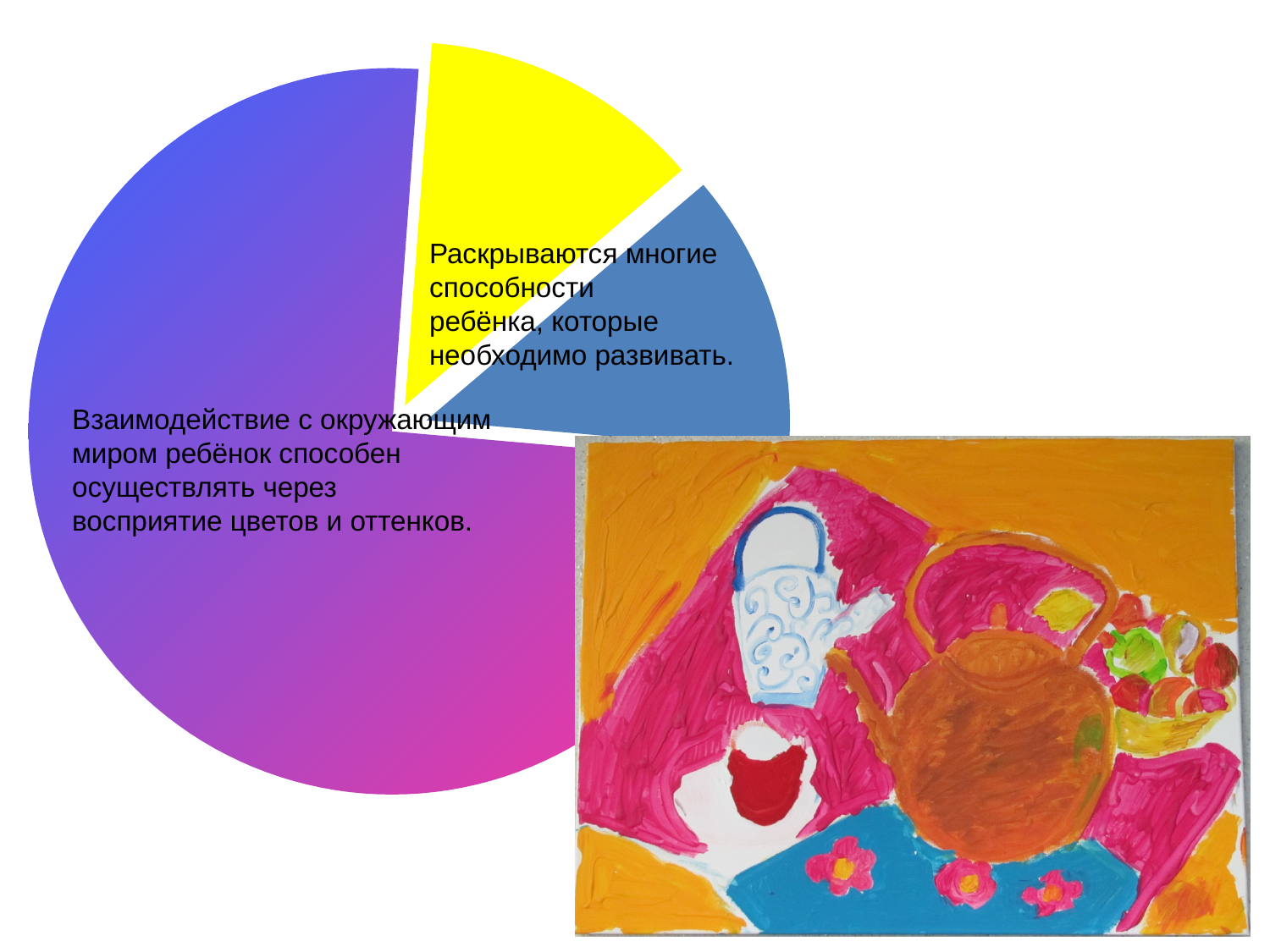
Which slice is larger, the purple slice or the blue slice? the purple slice Which slice of the pie chart is the largest? the purple slice Does the pie chart have a legend? no What colours are the three slices of the pie chart? purple, yellow and blue How many slices does the pie chart have? 3 Which slice is larger, the purple slice or the yellow slice? the purple slice What kind of chart is shown on the slide? pie chart